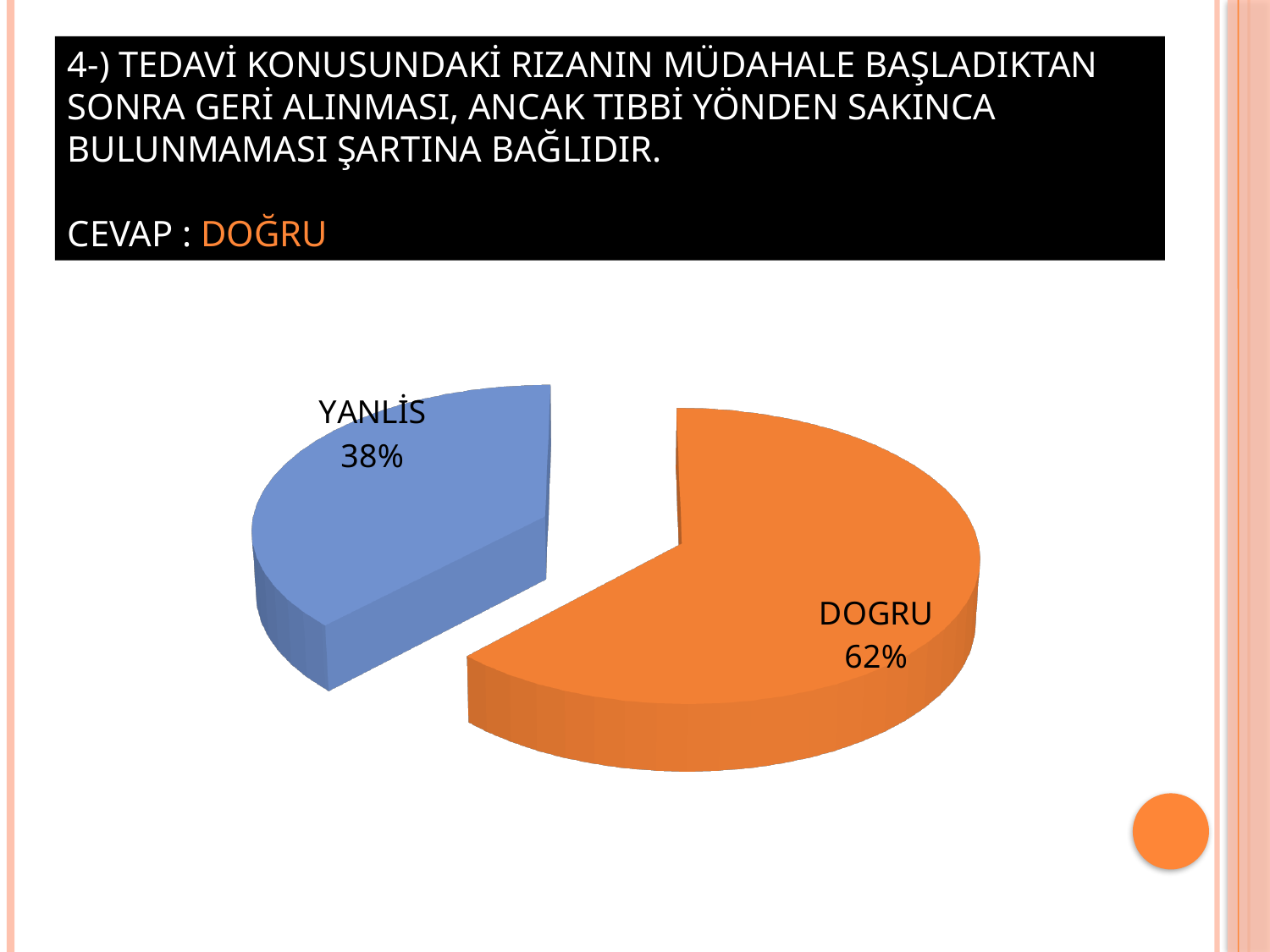
What is the difference in percentage points between the DOGRU and YANLİS slices? 24 Which slice is the largest in the pie chart? DOGRU What percentage does the YANLİS slice show? 38% What colour is the YANLİS slice? blue What percentage does the DOGRU slice show? 62% Which slice is the smallest in the pie chart? YANLİS What share of the pie does the YANLİS slice represent? 38% Which is larger, the DOGRU slice or the YANLİS slice? DOGRU How many slices does the pie chart have? 2 What kind of chart is shown on the slide? pie chart What colour is the DOGRU slice? orange